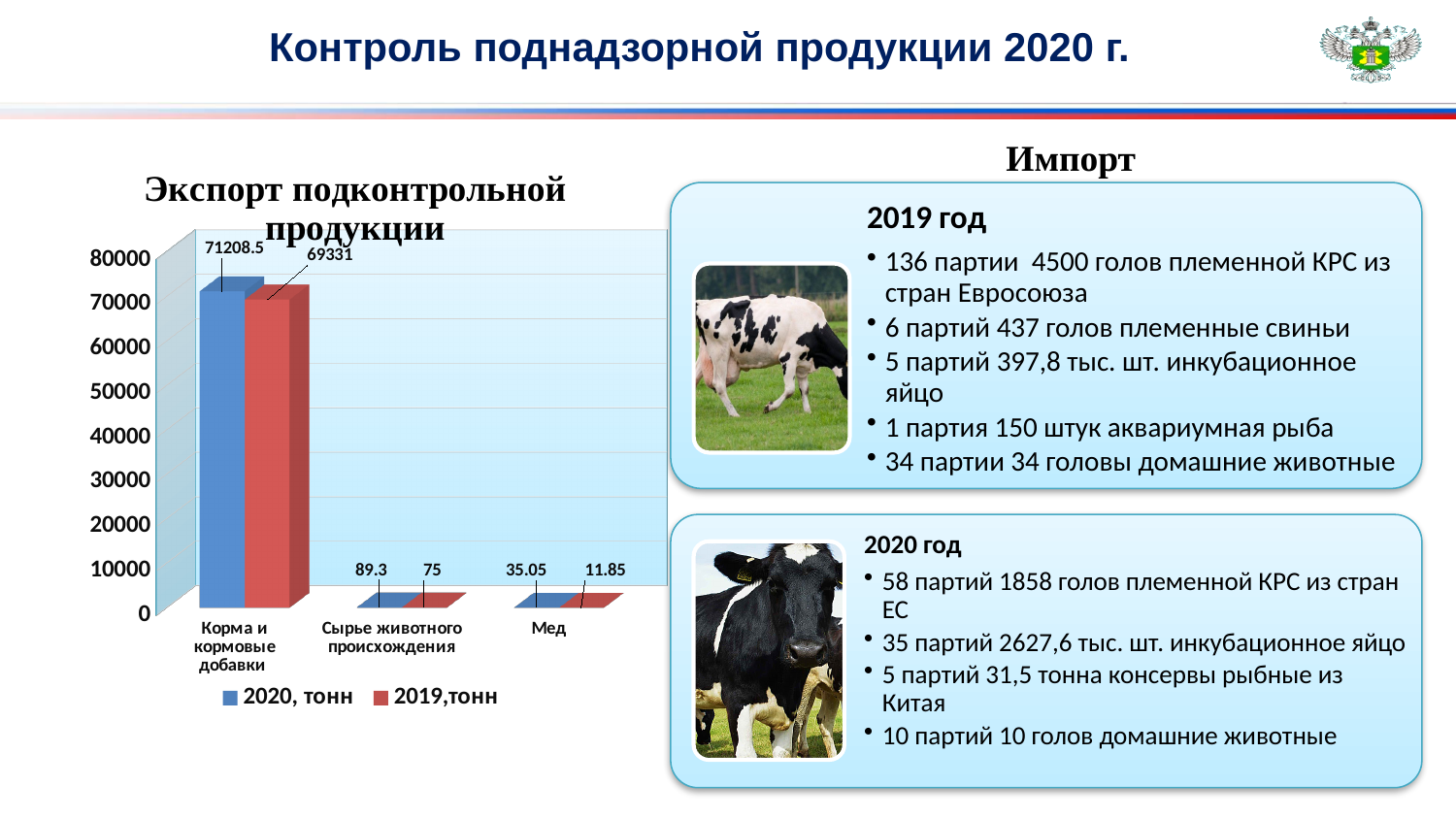
What is the 2019 value (тонн) for Корма и кормовые добавки? 69331 Which category has the lowest 2019 value? Мед What is the 2020 value for Сырье животного происхождения? 89.3 What is the title of the chart? Экспорт подконтрольной продукции What type of chart is shown on the slide? bar chart Which is larger for Мед: the 2020 value or the 2019 value? 2020 What is the 2019 value for Мед? 11.85 How many categories are shown on the x axis of the chart? 3 How many series does the chart legend list? 2 What is the 2020 value (тонн) for Корма и кормовые добавки? 71208.5 What is the difference between the 2020 and 2019 values for Сырье животного происхождения? 14.3 Which category has the highest 2020 value? Корма и кормовые добавки